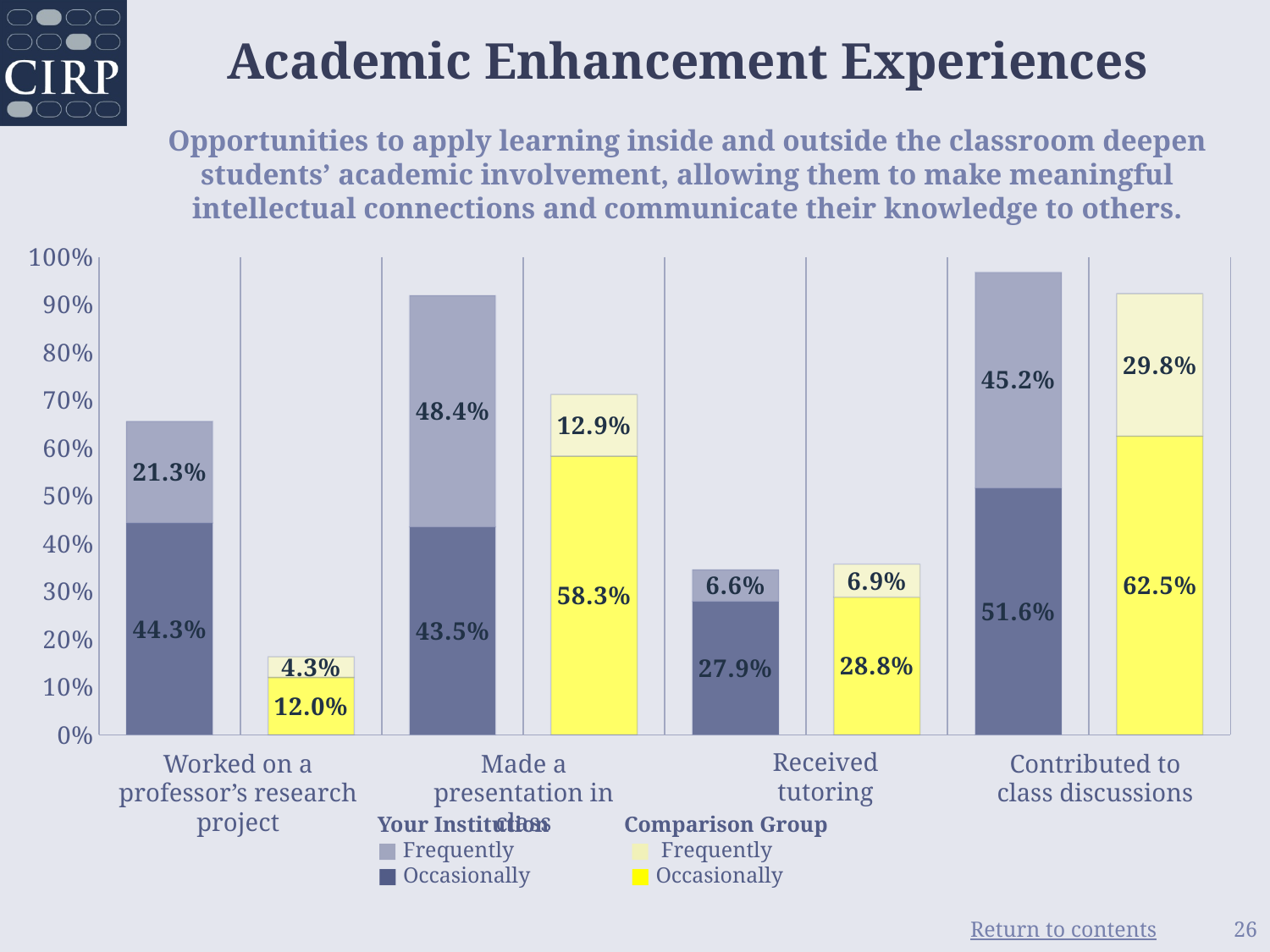
Which category has the highest total stacked bar for Your Institution? Contributed to class discussions What percentage of students at Your Institution reported occasionally receiving tutoring? 27.9% What percentage of the Comparison Group reported occasionally making a presentation in class? 58.3% Which is larger: the 'Occasionally' value for Your Institution or for the Comparison Group for 'Contributed to class discussions'? Comparison Group What percentage of students at Your Institution reported frequently working on a professor's research project? 21.3% Which category has the lowest total stacked bar for the Comparison Group? Worked on a professor's research project What percentage of the Comparison Group reported frequently contributing to class discussions? 29.8% What kind of chart is shown on the slide? Stacked bar chart How many categories are shown on the x axis of the chart? 4 What is the difference between Your Institution's and the Comparison Group's 'Frequently' values for 'Made a presentation in class'? 35.5% What is the total stacked bar value for Your Institution for 'Contributed to class discussions'? 96.8% What is the total stacked bar value for the Comparison Group for 'Worked on a professor's research project'? 16.3%